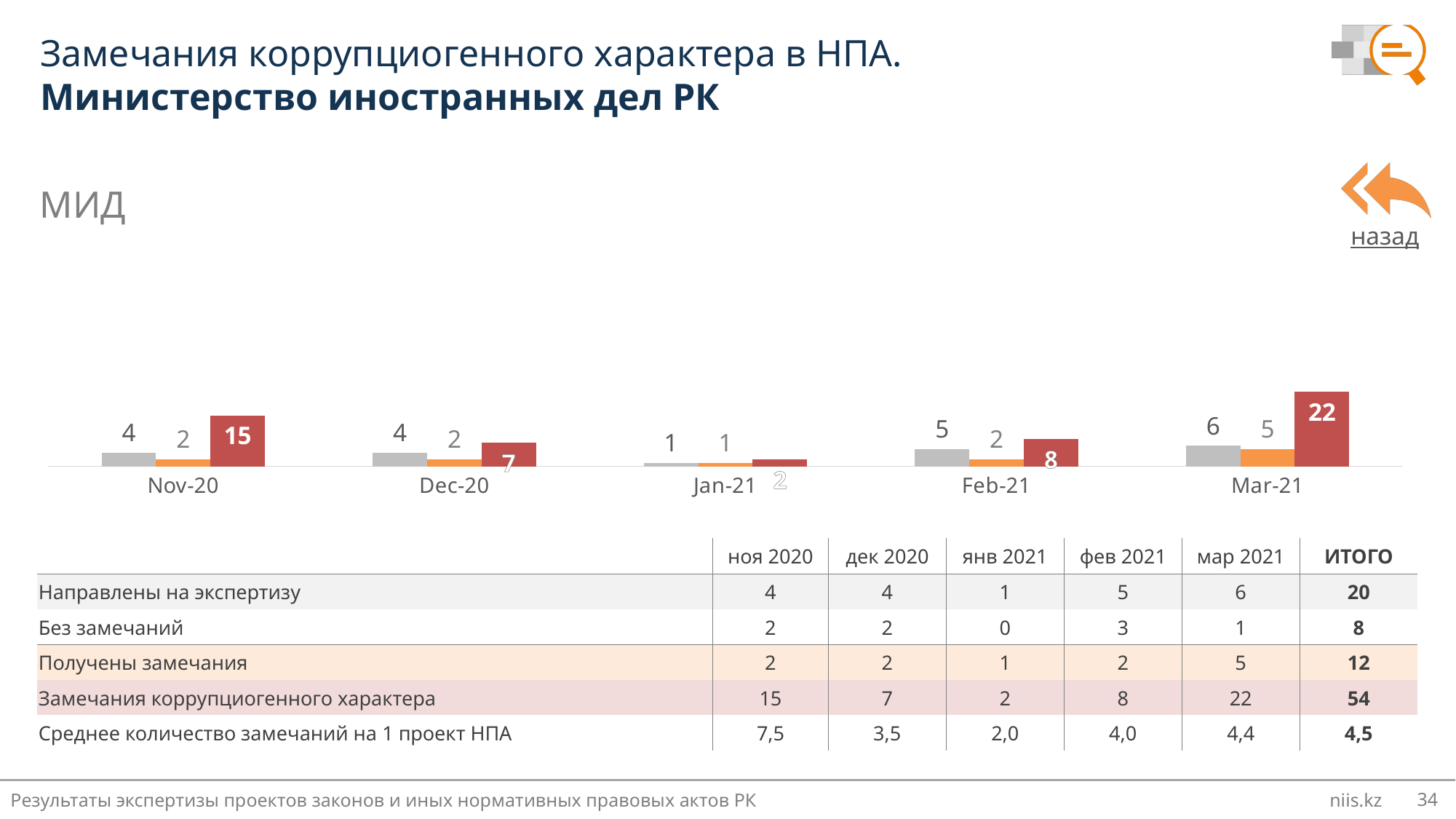
How many months (categories) are shown on the x axis of the chart? 5 What is the value of the orange bar for Mar-21? 5 In which month is the red bar lowest? Jan-21 What is the value of the red bar for Mar-21? 22 How many differently coloured bar series are plotted for each month? 3 What is the value of the red bar for Nov-20? 15 What is the value of the grey bar for Feb-21? 5 What is the difference between the grey bar values for Mar-21 and Jan-21? 5 In which month is the red bar highest? Mar-21 Which is larger, the red bar for Dec-20 or the red bar for Feb-21? Feb-21 What kind of chart is shown on the slide? bar chart What is the difference between the red bar values for Mar-21 and Nov-20? 7